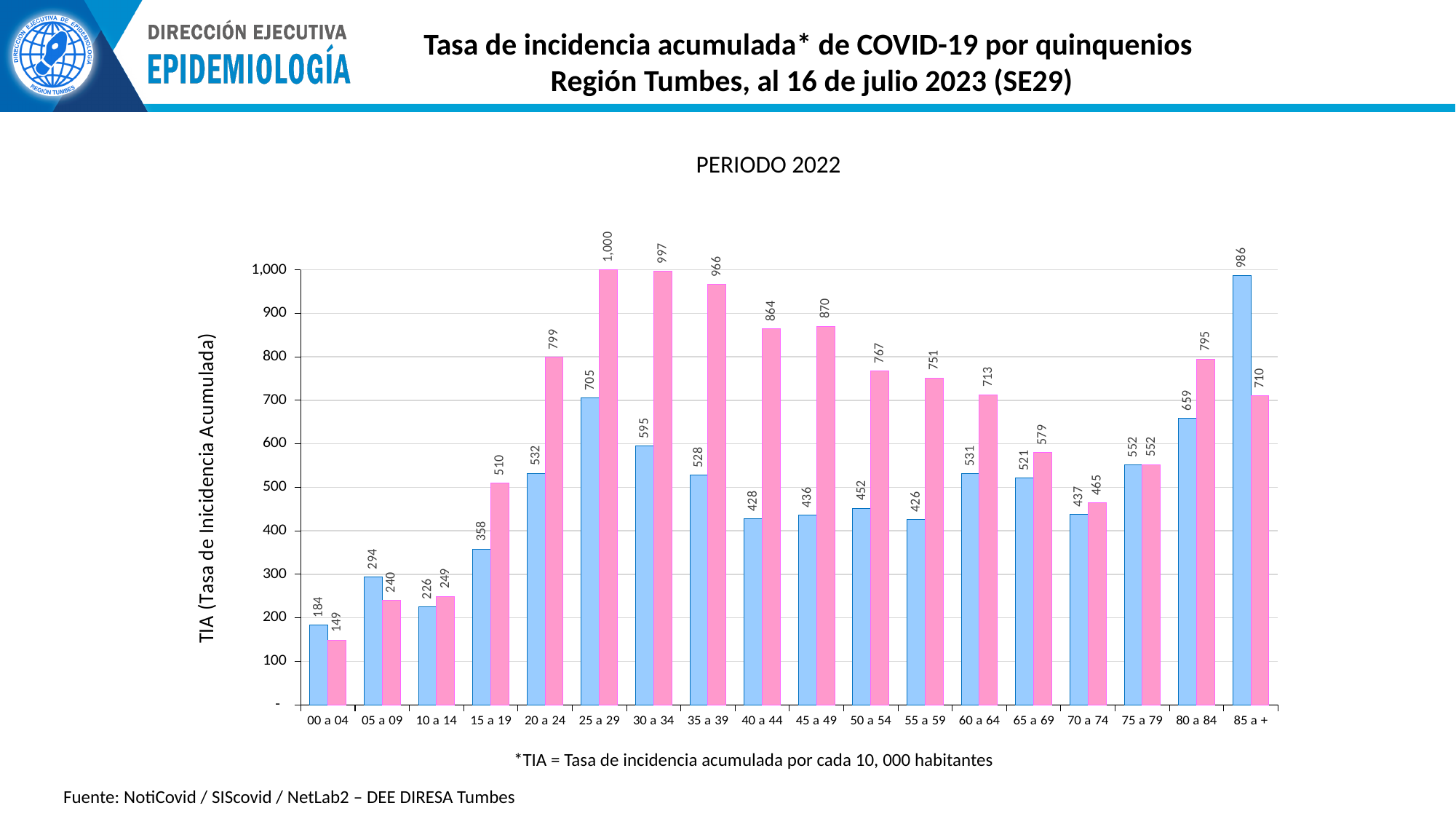
What is the difference between the pink bars for the 20 a 24 and 15 a 19 age groups? 289 What kind of chart is shown on the slide? bar chart Which age group has the lowest blue bar? 00 a 04 Which age group has the highest blue bar? 85 a + What is the y-axis label of the chart? TIA (Tasa de Incidencia Acumulada) What is the value of the pink bar for the 40 a 44 age group? 864 Which is larger for the 05 a 09 age group, the blue bar or the pink bar? the blue bar Is the pink bar for the 30 a 34 age group greater or less than 900? greater What is the difference between the pink and blue bars for the 85 a + age group? 276 What is the value of the blue bar for the 25 a 29 age group? 705 How many age groups are shown on the x axis? 18 Which age group has the highest pink bar? 25 a 29